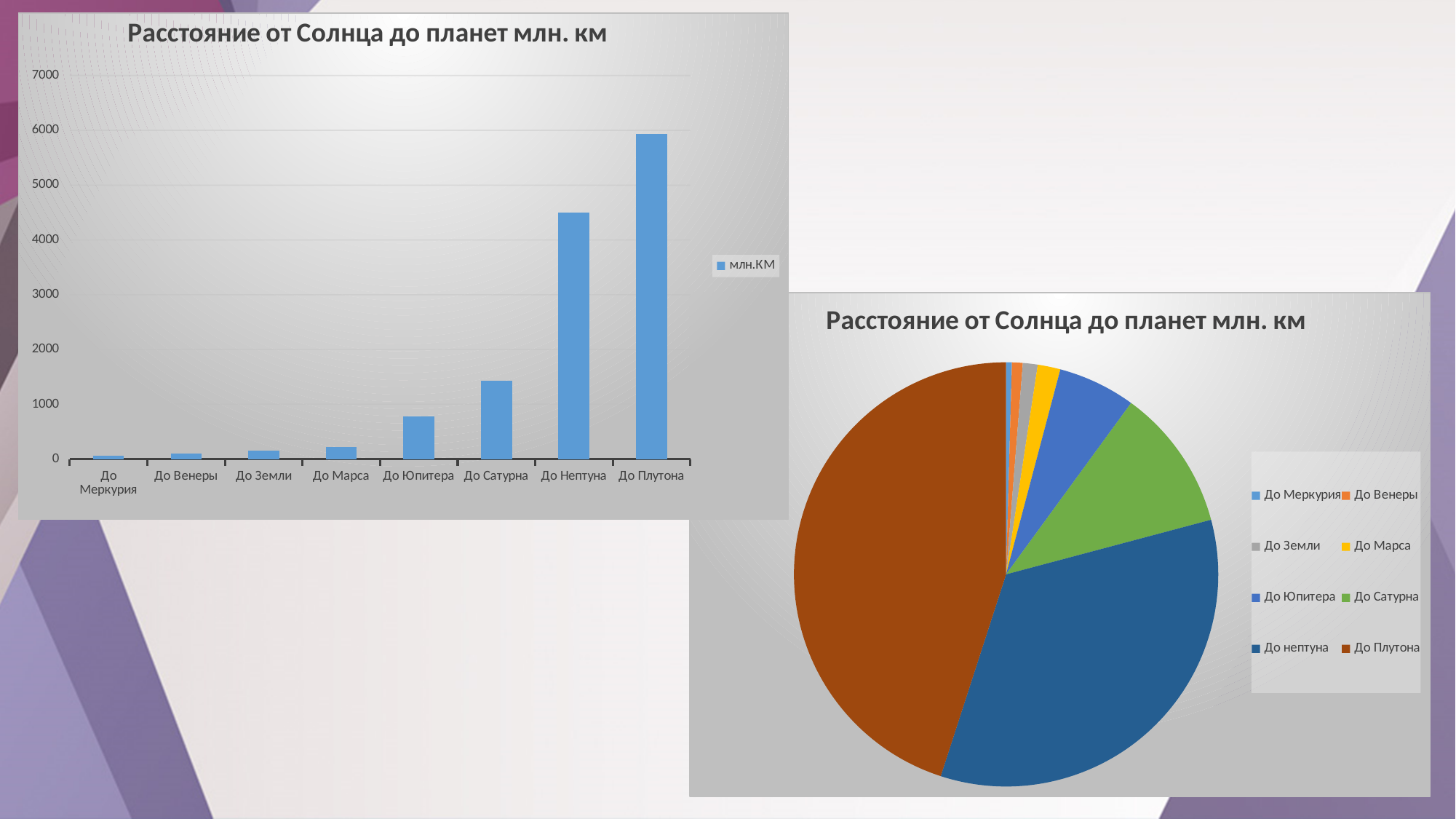
In the bar chart on the left, which category has the lowest value? До Меркурия In the bar chart on the left, is the value for До Плутона greater or less than 5000? greater What kind of chart is the chart on the left of the slide? bar chart Do the values in the bar chart on the left rise or fall from left to right along the x axis? rise In the bar chart on the left, which is larger: the value for До Нептуна or the value for До Сатурна? До Нептуна In the bar chart on the left, which category has the highest value? До Плутона How many categories are shown on the x axis of the bar chart on the left? 8 In the bar chart on the left, is the value for До Нептуна greater or less than 5000? less In the pie chart on the right, which slice is the largest? До Плутона In the bar chart on the left, is the value for До Юпитера greater or less than 1000? less What kind of chart is the chart on the right of the slide? pie chart